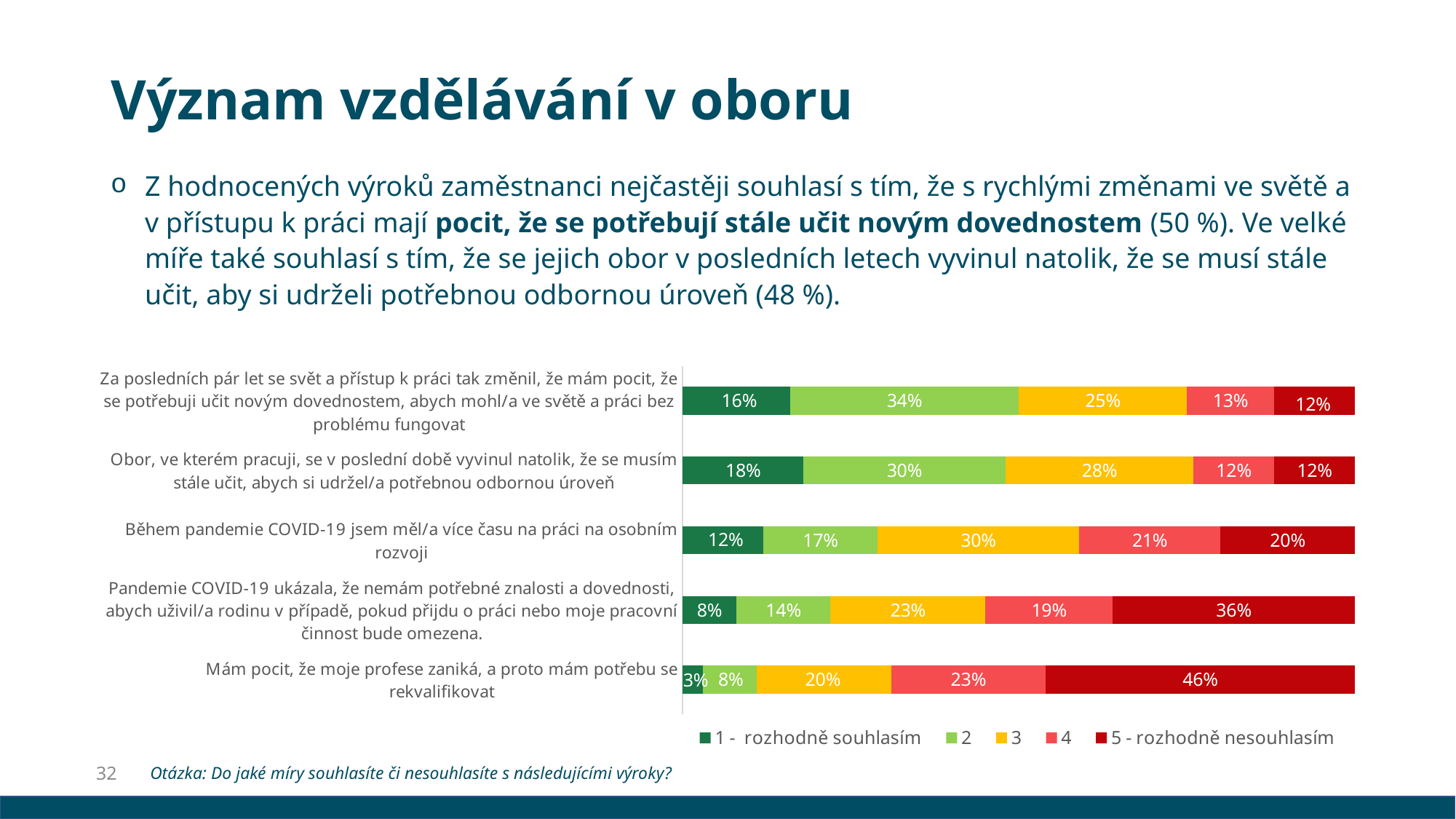
What kind of chart is shown on the slide? Stacked bar chart What is the difference between the "2" values for "Za posledních pár let se svět a přístup k práci tak změnil..." (34%) and "Obor, ve kterém pracuji..." (30%)? 4% How many series does the legend list? 5 Which is larger: the "4" value for "Pandemie COVID-19 ukázala, že nemám potřebné znalosti a dovednosti..." or the "4" value for "Během pandemie COVID-19 jsem měl/a více času na práci na osobním rozvoji"? Během pandemie COVID-19 jsem měl/a více času na práci na osobním rozvoji Which statement has the highest value for "5 - rozhodně nesouhlasím"? Mám pocit, že moje profese zaniká, a proto mám potřebu se rekvalifikovat Which legend entry is shown in dark red? 5 - rozhodně nesouhlasím What is the value of series "3" for the statement "Během pandemie COVID-19 jsem měl/a více času na práci na osobním rozvoji"? 30% What is the value of "5 - rozhodně nesouhlasím" for the statement "Mám pocit, že moje profese zaniká, a proto mám potřebu se rekvalifikovat"? 46% How many statements (categories) are plotted in the chart? 5 What is the value of "1 - rozhodně souhlasím" for the statement "Obor, ve kterém pracuji, se v poslední době vyvinul natolik, že se musím stále učit, abych si udržel/a potřebnou odbornou úroveň"? 18% Which statement has the lowest value for "1 - rozhodně souhlasím"? Mám pocit, že moje profese zaniká, a proto mám potřebu se rekvalifikovat What is the combined share of "1 - rozhodně souhlasím" and "2" for the statement "Za posledních pár let se svět a přístup k práci tak změnil..."? 50%